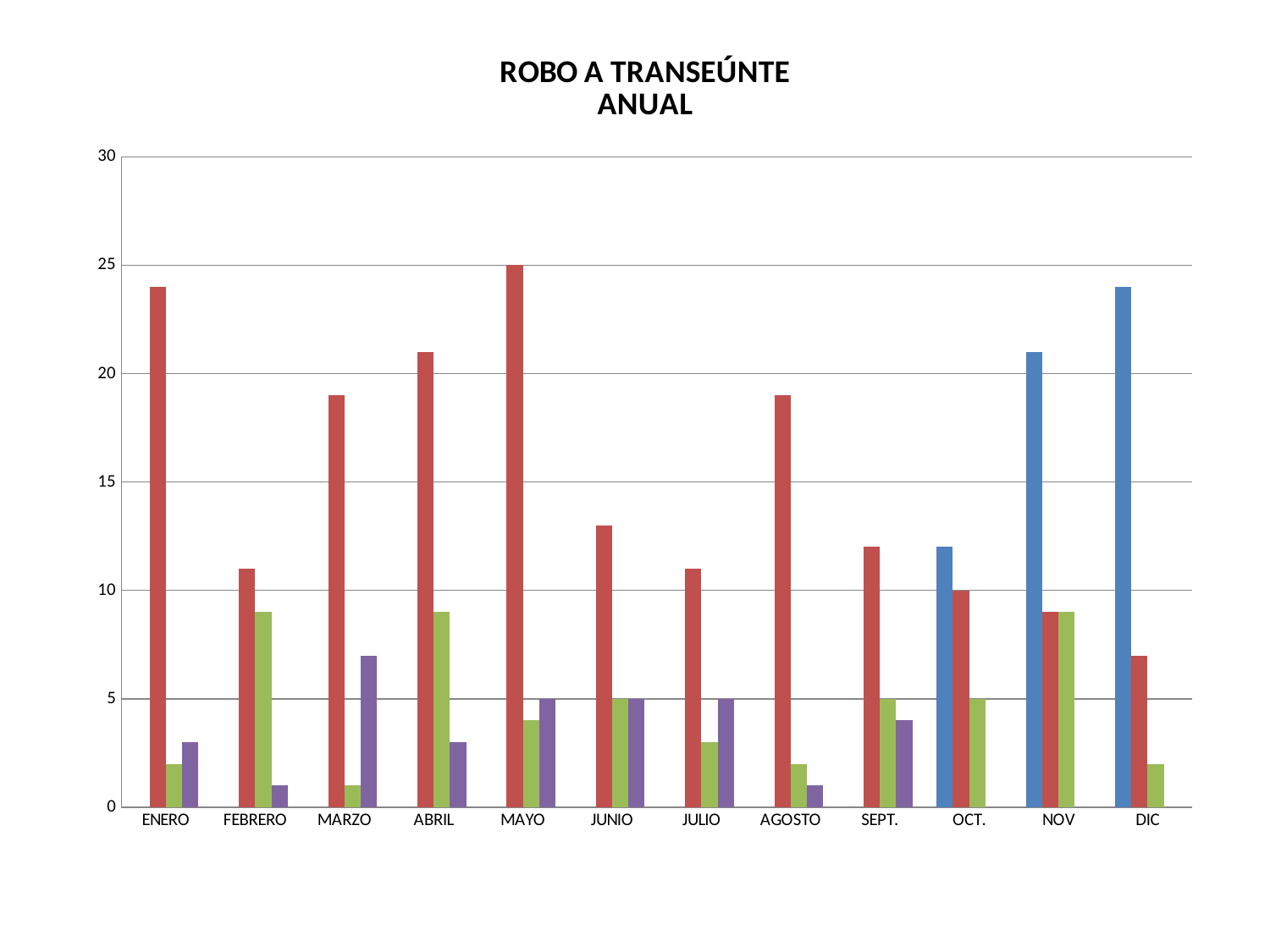
Is the value of the blue bar for DIC greater or less than 20? greater Which is larger, the red bar for ENERO or the red bar for FEBRERO? ENERO Is the value of the red bar for AGOSTO greater or less than 20? less How many months are shown along the x axis of the chart? 12 Which is larger, the purple bar for MARZO or the purple bar for ABRIL? MARZO What is the value of the red bar for OCT.? 10 What is the value of the green bar for JUNIO? 5 Is the value of the green bar for ABRIL greater or less than 10? less What is the value of the red bar for MAYO? 25 What kind of chart is shown on the slide? bar chart What is the title of the chart? ROBO A TRANSEÚNTE ANUAL